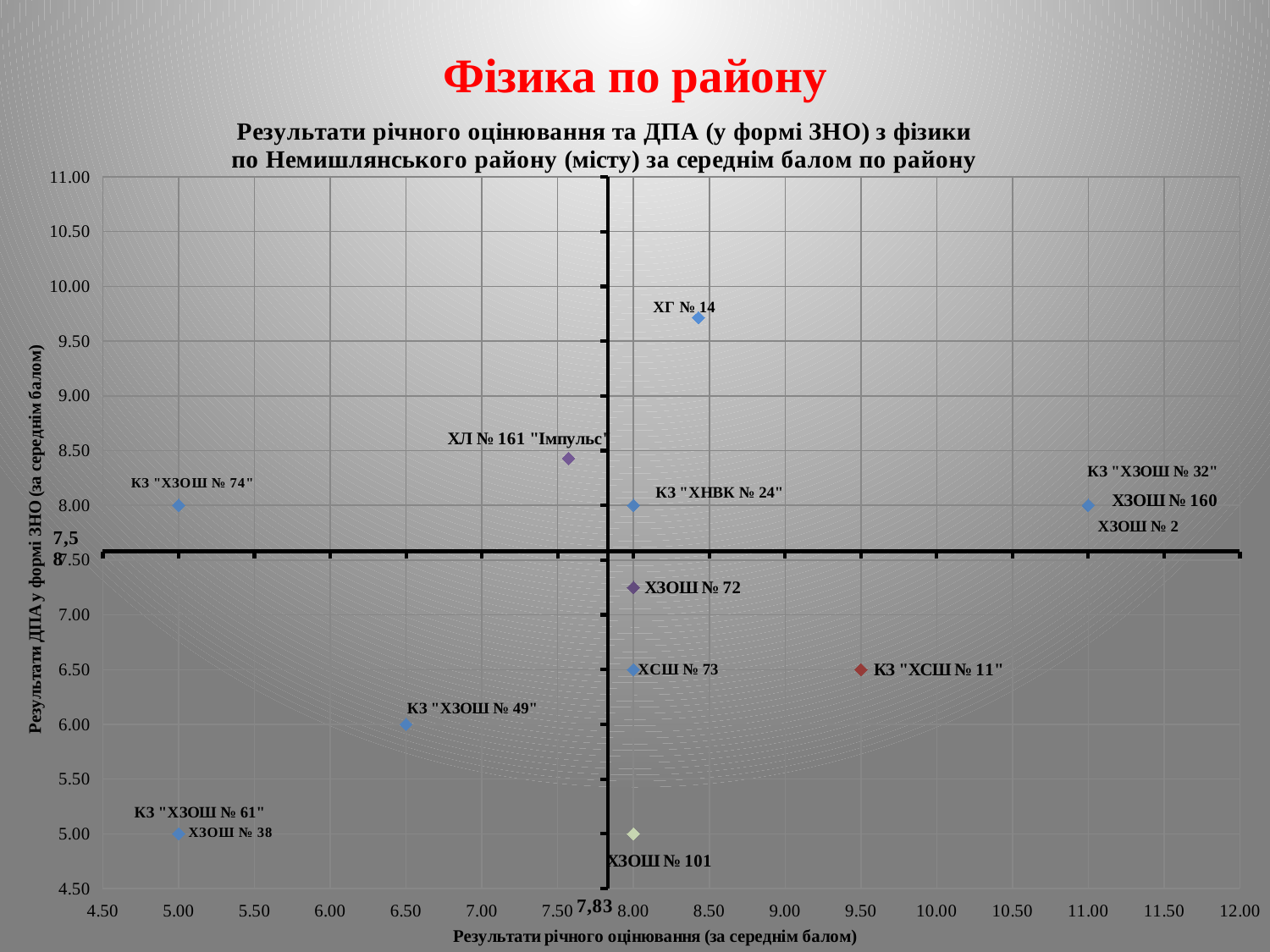
What is the annual assessment result for ХСШ № 73? 8.00 Which school has the highest ДПА (ЗНО) result on the chart? ХГ № 14 Which has the higher ДПА result, ХГ № 14 or ХЗОШ № 72? ХГ № 14 Is the ДПА result for ХГ № 14 greater or less than 9.50? greater Is the annual assessment result for КЗ "ХСШ № 11" greater or less than 9.00? greater What is the ДПА result for КЗ "ХЗОШ № 49"? 6.00 What is the ДПА result for КЗ "ХСШ № 11"? 6.50 Is the annual assessment result for ХЛ № 161 "Імпульс" greater or less than 8.00? less What is the label of the x axis? Результати річного оцінювання (за середнім балом) What kind of chart is shown on the slide? scatter chart Which has the higher annual assessment result, КЗ "ХСШ № 11" or КЗ "ХЗОШ № 49"? КЗ "ХСШ № 11" What district-average annual assessment value is marked on the x axis where the vertical axis line crosses? 7,83